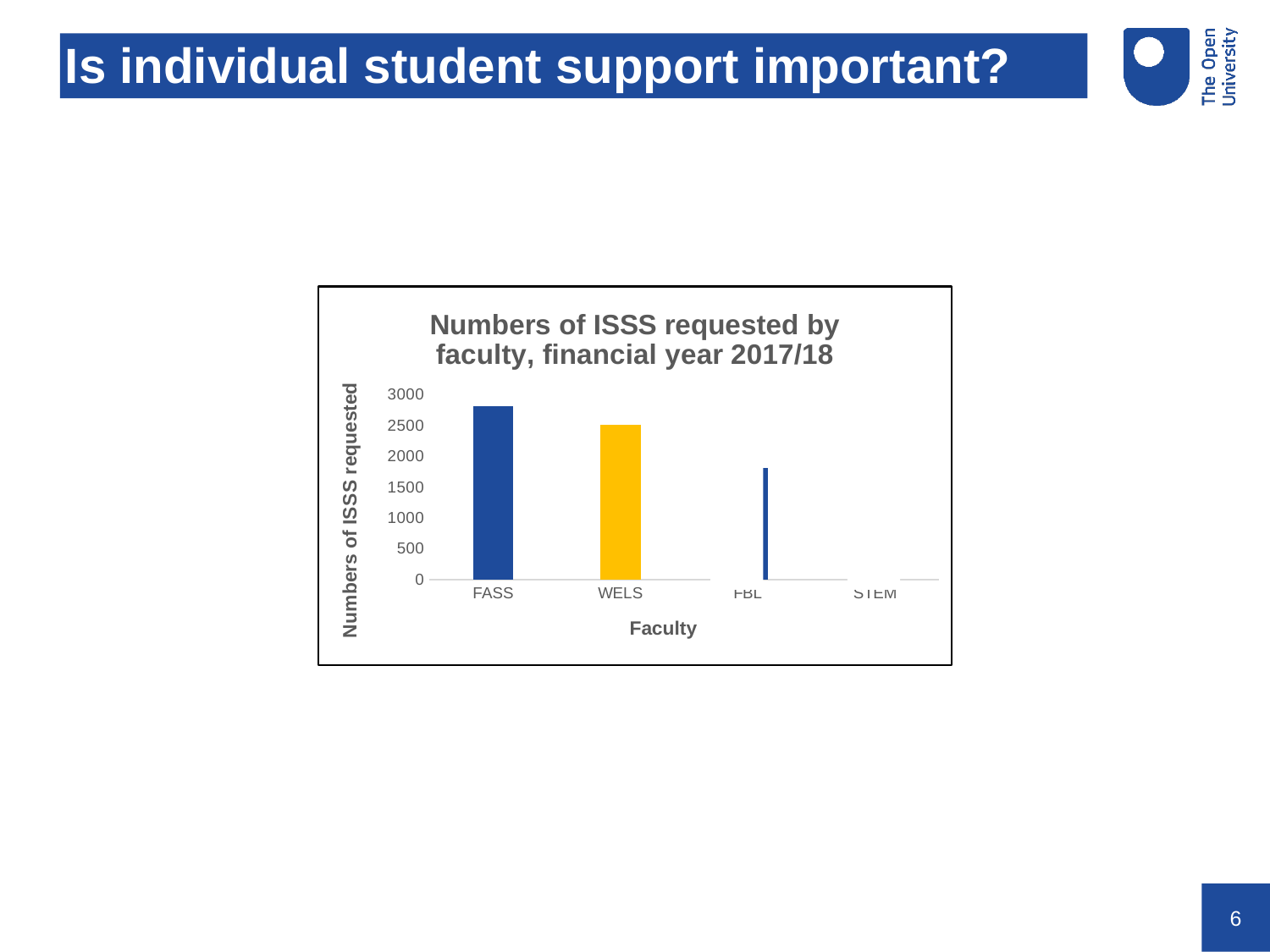
Is the value for FBL greater or less than 2000? less Is the value for WELS greater or less than 2000? greater Which has more ISSS requested, FASS or WELS? FASS Which faculty has the highest number of ISSS requested? FASS What is the label on the vertical axis of the chart? Numbers of ISSS requested Which has more ISSS requested, WELS or FBL? WELS How many faculties are shown on the x axis of the chart? 4 Is the value for FASS greater or less than 3000? less What kind of chart is shown on the slide? bar chart What is the title of the chart? Numbers of ISSS requested by faculty, financial year 2017/18